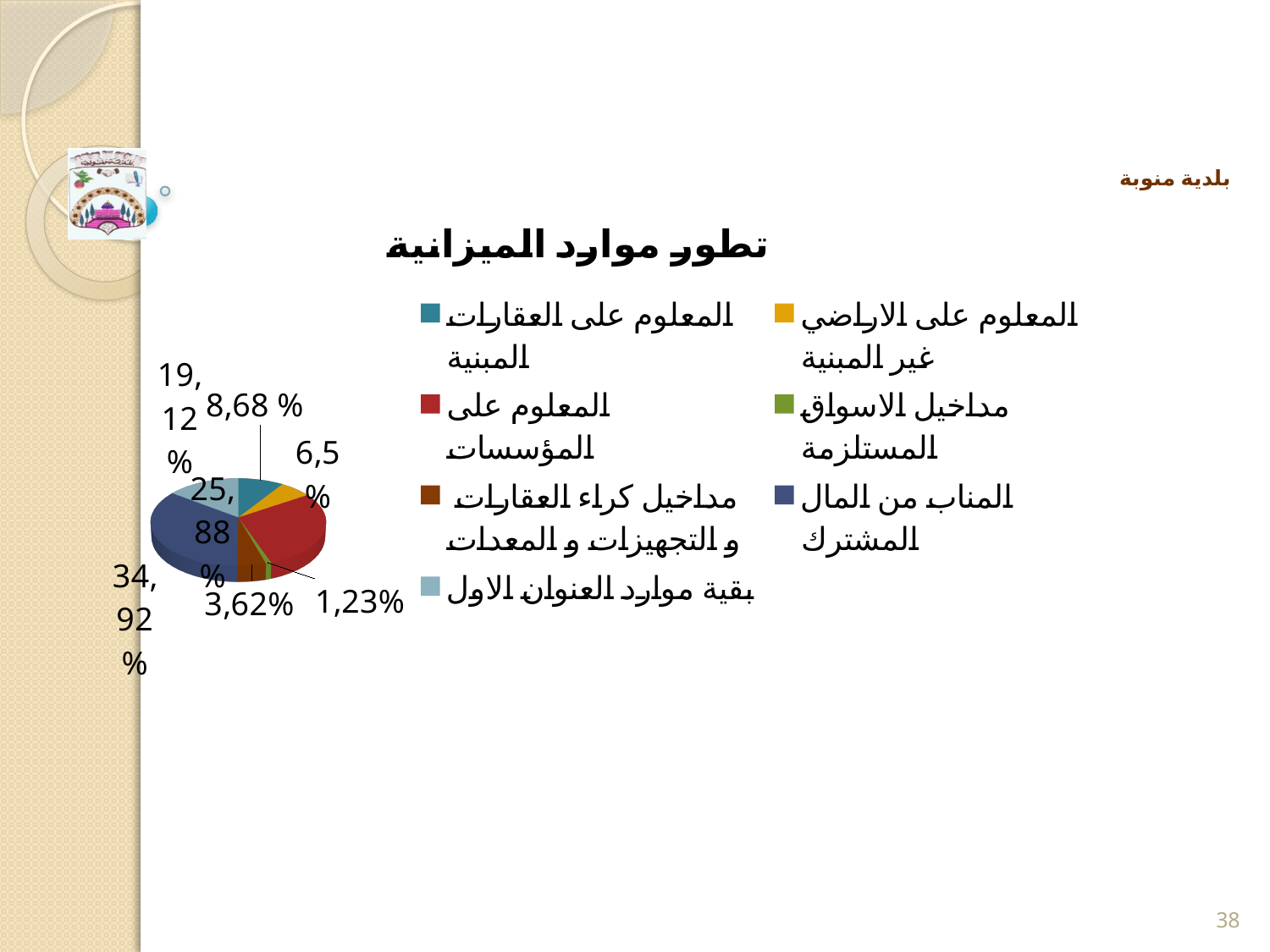
Which category has the smallest slice of the pie chart? مداخيل الاسواق المستلزمة What is the difference between the largest slice (34,92 %) and the slice for المعلوم على المؤسسات (25,88 %)? 9,04 % Which is larger: the slice labelled 8,68 % or the slice labelled 6,5 %? 8,68 % What is the largest share shown on the pie chart? 34,92 % Which category has the largest slice of the pie chart? المناب من المال المشترك What kind of chart is shown on the slide? pie chart What is the smallest share shown on the pie chart? 1,23% How many categories does the legend of the pie chart list? 7 What share of the pie does بقية موارد العنوان الاول represent? 19,12 % What is the title of the chart? تطور موارد الميزانية What share of the pie does المعلوم على المؤسسات represent? 25,88 % Which colour represents المناب من المال المشترك in the legend? dark blue